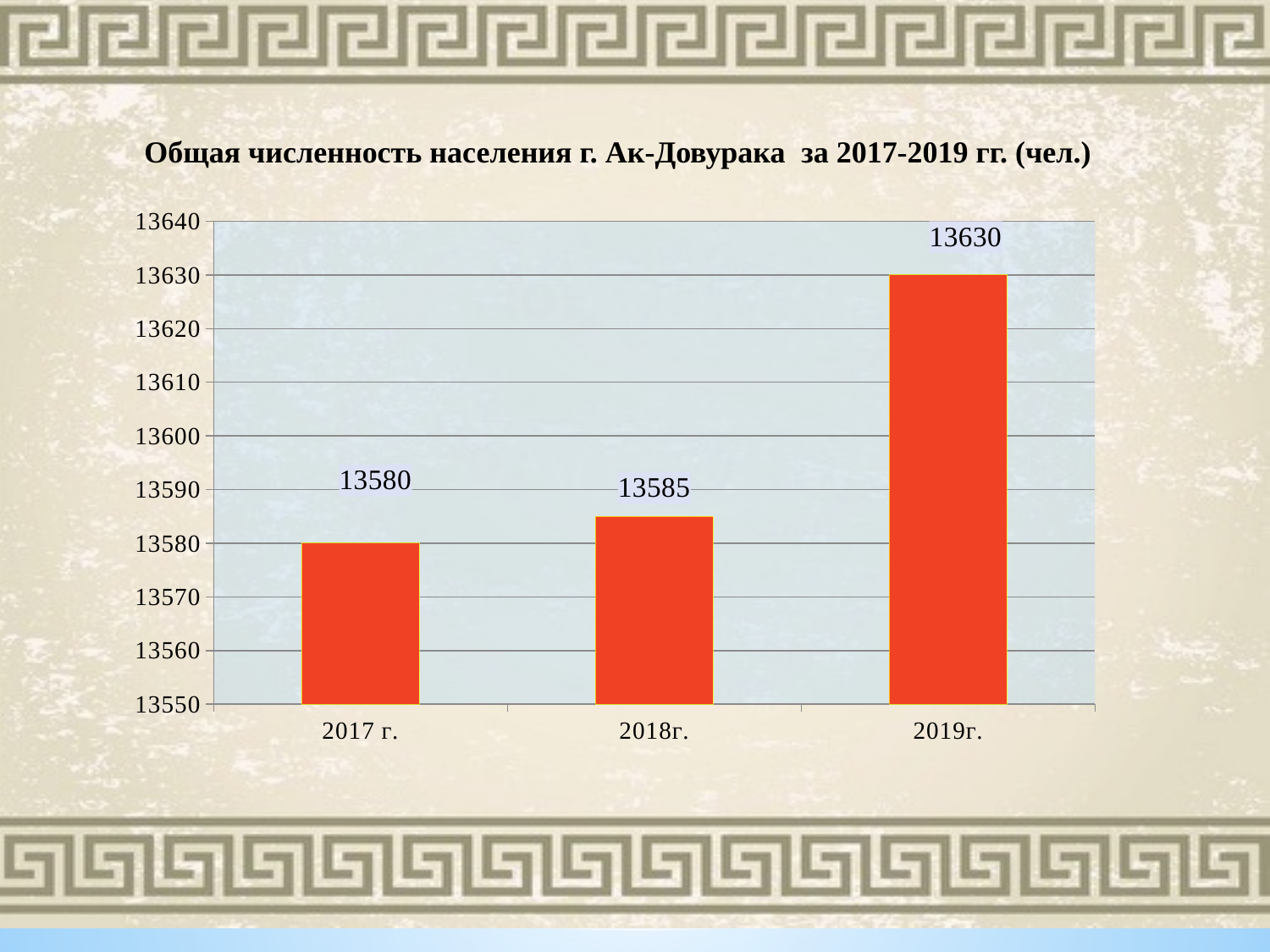
What is the population value shown for 2018г.? 13585 What kind of chart is shown on the slide? bar chart Do the values rise or fall from 2017 г. to 2019г.? rise How many years (categories) are shown on the chart? 3 Is the value for 2019г. greater or less than 13600? greater What is the difference between the population values for 2019г. and 2017 г.? 50 Which year has the highest population value? 2019г. What is the population value shown for 2017 г.? 13580 Which is larger, the value for 2019г. or the value for 2018г.? 2019г. What is the population value shown for 2019г.? 13630 What is the difference between the population values for 2018г. and 2017 г.? 5 Which year has the lowest population value? 2017 г.